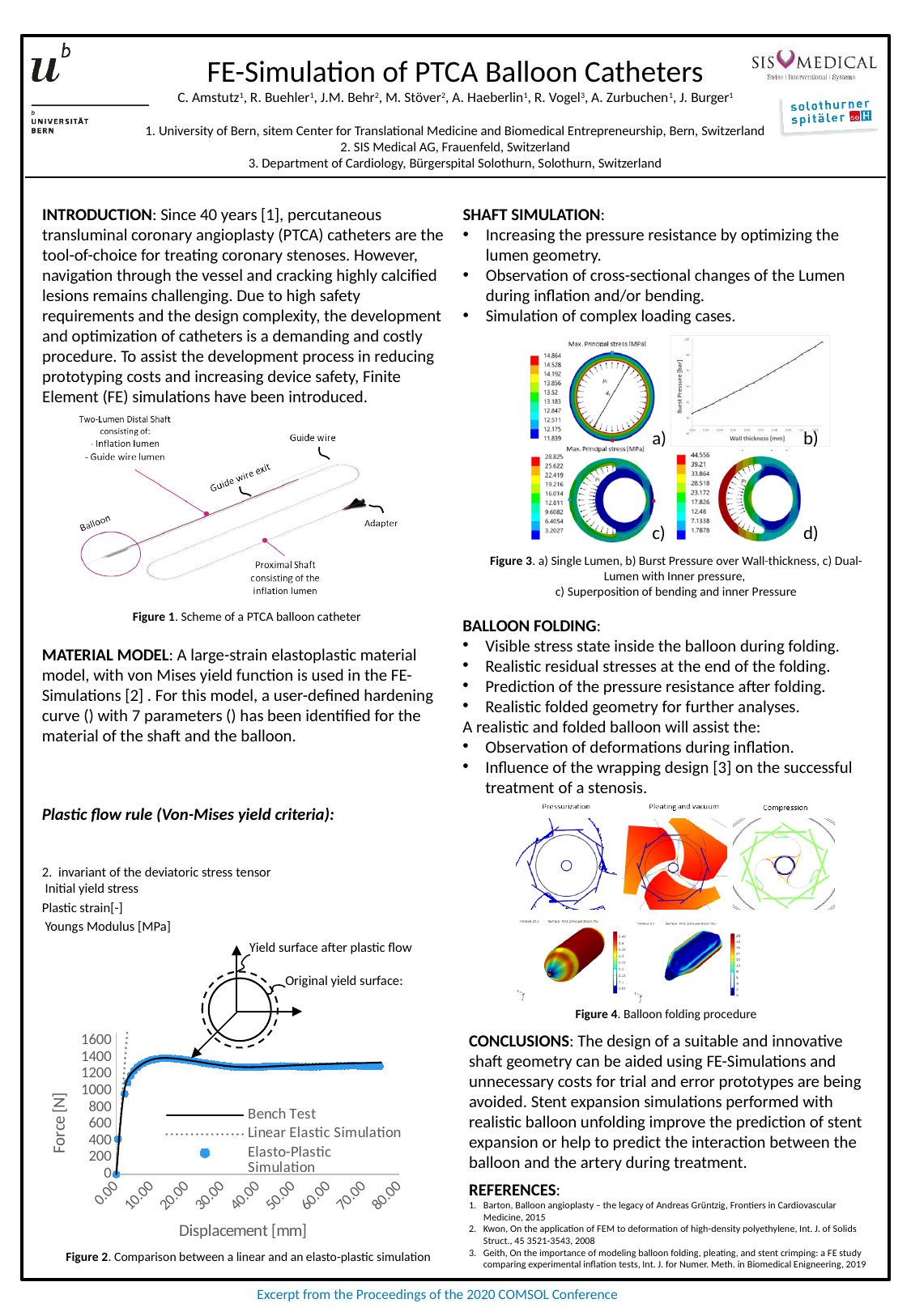
In Figure 2, how many series does the legend list? 3 In Figure 2, what kind of chart is used to compare the bench test with the simulations? Line chart In Figure 3b, what quantity is plotted on the vertical axis against wall thickness? Burst Pressure [bar] In Figure 2, is the Bench Test force at a displacement of 40.00 mm greater or less than 1000 N? greater In Figure 2, what is the label of the vertical axis? Force [N] In Figure 2, what is the highest tick value shown on the Displacement axis? 80.00 In Figure 2, how does the Bench Test force change as displacement increases from 0.00 to 10.00 mm? It rises steeply In Figure 2, what are the three legend entries? Bench Test, Linear Elastic Simulation, Elasto-Plastic Simulation In Figure 2, which series is drawn as a dotted line? Linear Elastic Simulation In Figure 2, is the Bench Test force at a displacement of 40.00 mm greater or less than 1600 N? less In Figure 2, what is the highest tick value shown on the Force axis? 1600 In Figure 3b, does burst pressure rise or fall as wall thickness increases? rise